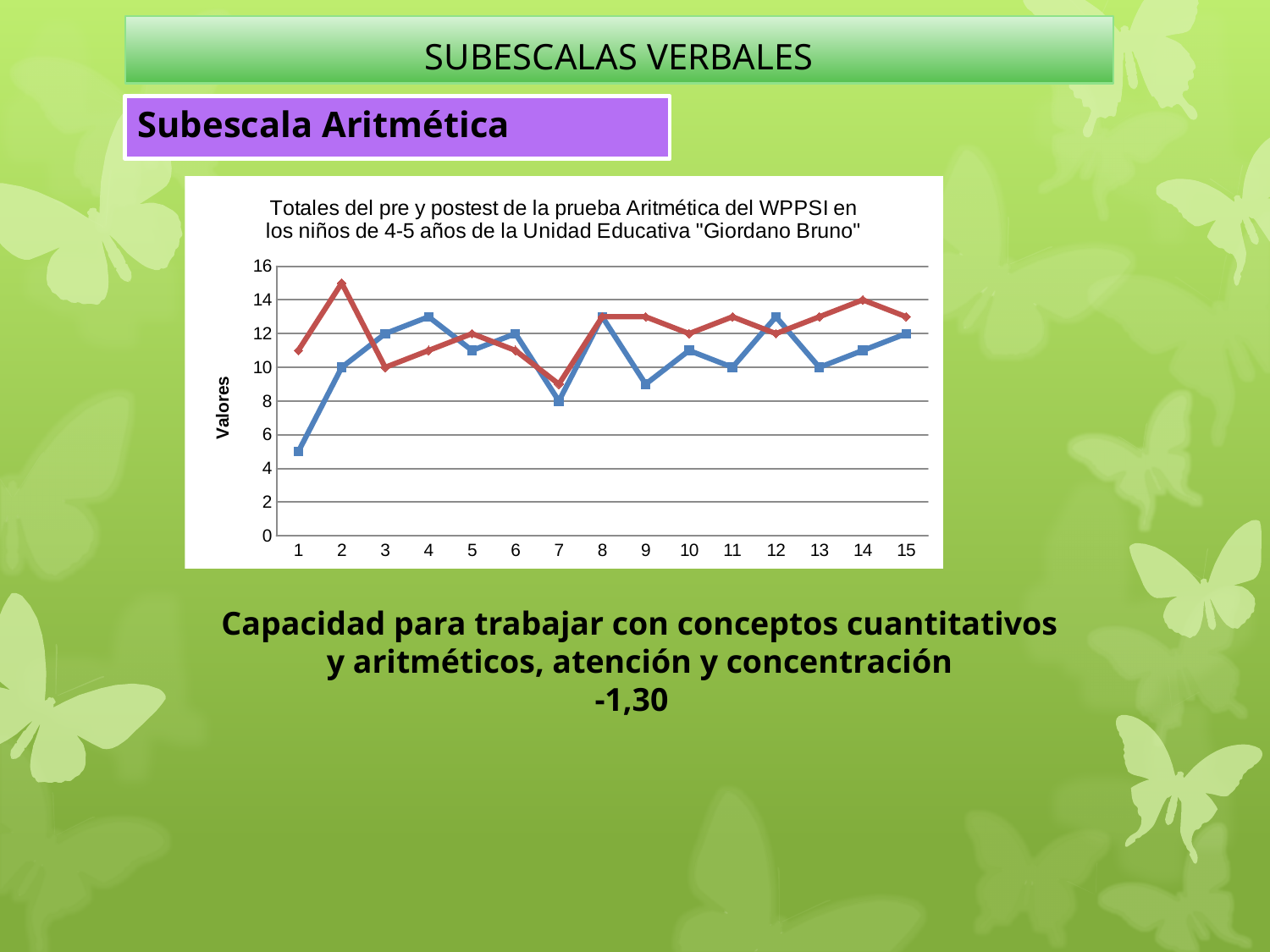
Is the value of the red line at point 2 greater or less than 14? greater What is the label of the vertical axis of the chart? Valores At which x-axis point does the blue line reach its lowest value? 1 What is the value of the red line at point 14? 14 At which x-axis point does the red line reach its highest value? 2 Is the value of the blue line at point 1 greater or less than 6? less How many lines (series) are plotted on the chart? 2 At point 1, which line has the higher value, the blue line or the red line? red line What is the value of the blue line at point 7? 8 How many points are plotted along the x axis of the chart? 15 What kind of chart is shown on the slide? line chart At point 2, which line has the higher value, the blue line or the red line? red line